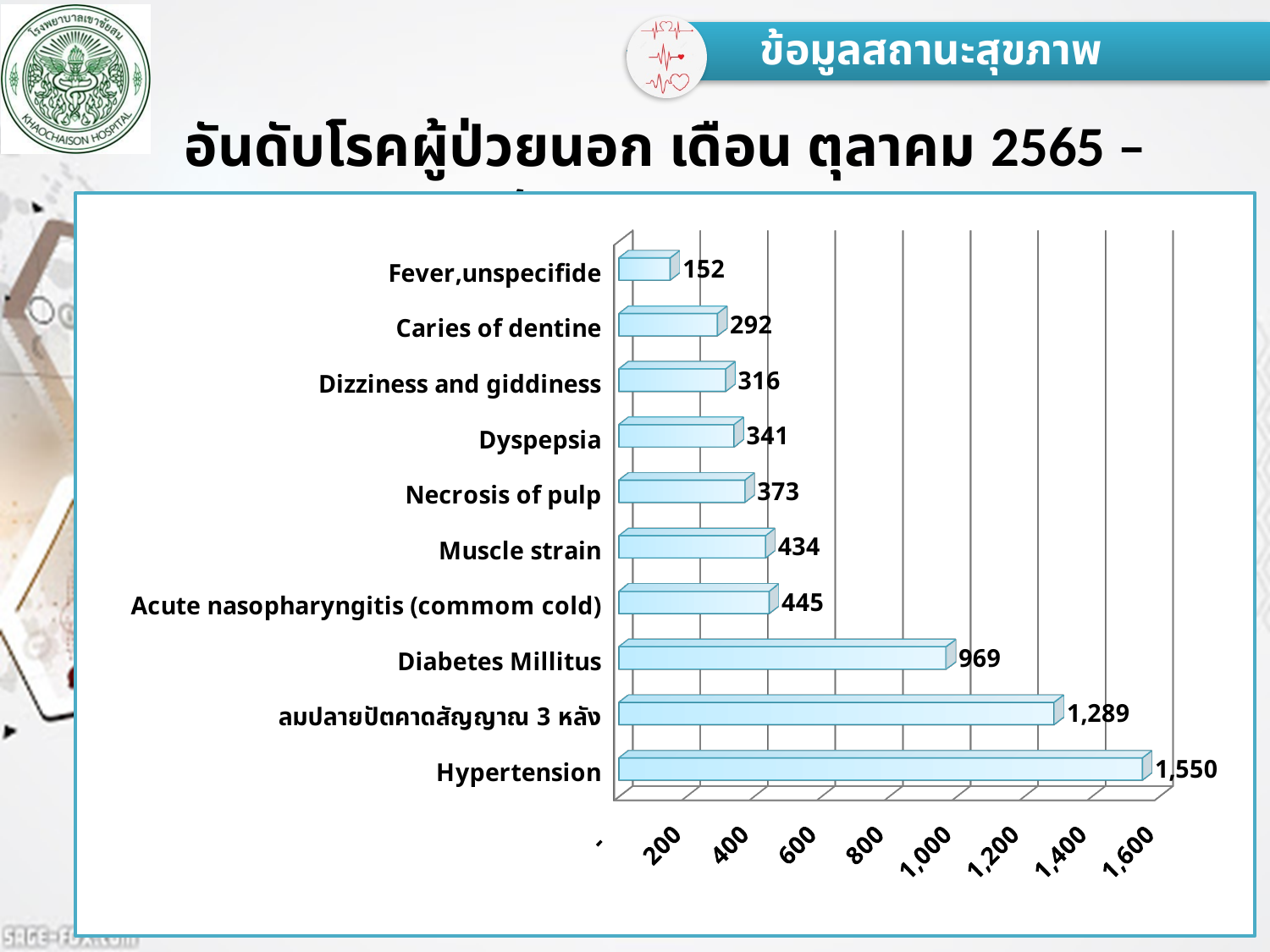
Which is larger, the value for Dyspepsia or the value for Necrosis of pulp? Necrosis of pulp What is the value for Diabetes Millitus? 969 How many categories are shown in the chart? 10 What is the value for Muscle strain? 434 Which category has the highest value? Hypertension What is the value for Caries of dentine? 292 What kind of chart is shown on the slide? Bar chart What is the difference between the values for Acute nasopharyngitis (commom cold) and Muscle strain? 11 What is the value for Hypertension? 1,550 What is the difference between the values for Hypertension and Diabetes Millitus? 581 Which category has the lowest value? Fever,unspecifide Is the value for Dizziness and giddiness greater or less than 400? less